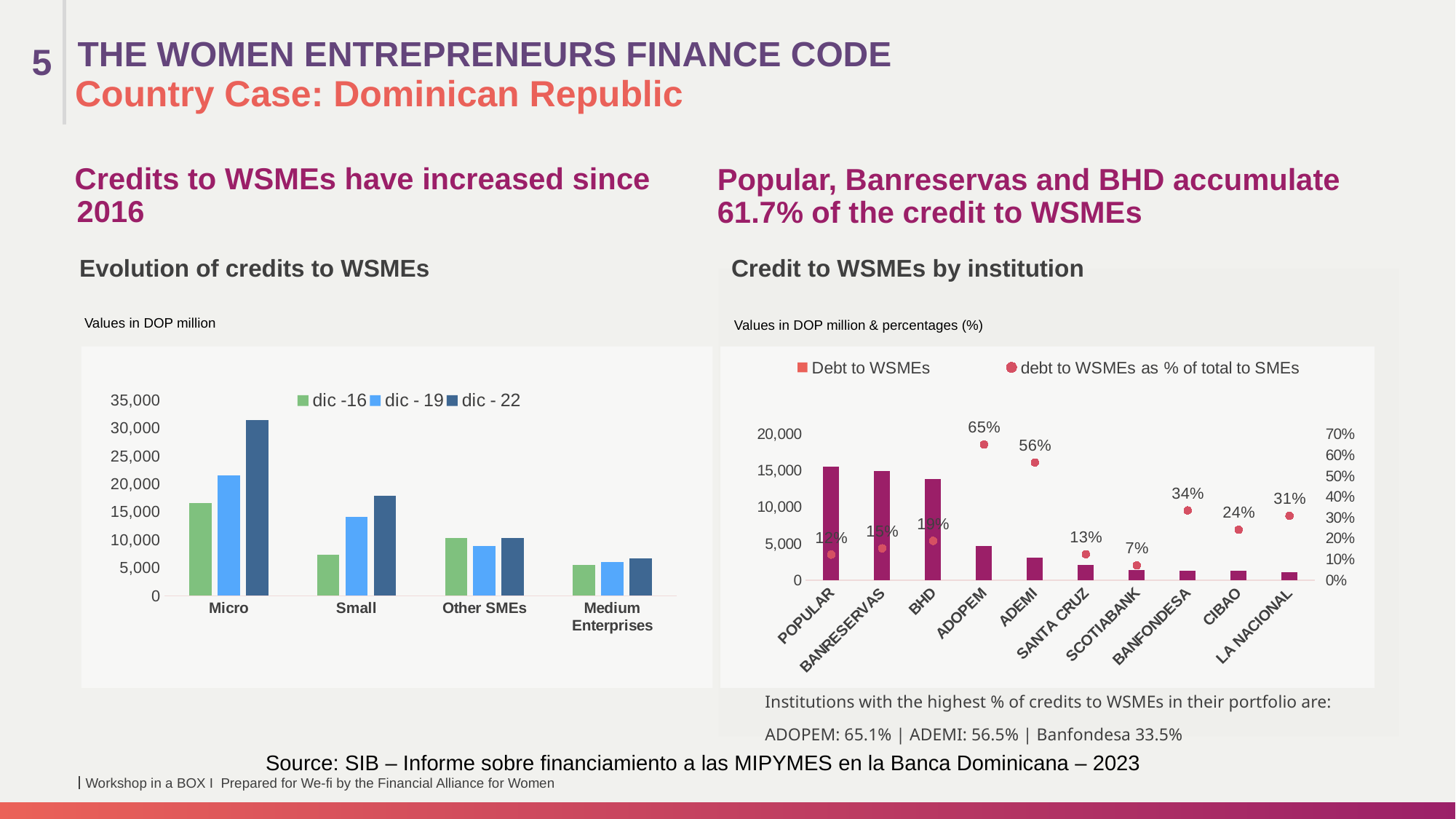
In the 'Evolution of credits to WSMEs' chart, do the values for Small rise or fall from dic -16 to dic - 22? rise How many series does the legend of the 'Evolution of credits to WSMEs' chart list? 3 In the 'Evolution of credits to WSMEs' chart, is the dic - 22 value for Micro greater or less than 30,000? greater How many categories are shown on the x axis of the 'Evolution of credits to WSMEs' chart? 4 What kind of chart is the 'Evolution of credits to WSMEs' chart? bar chart In the 'Evolution of credits to WSMEs' chart, for Other SMEs, which is larger: the dic -16 value or the dic - 19 value? dic -16 In the 'Credit to WSMEs by institution' chart, is the Debt to WSMEs bar for BHD greater or less than 10,000? greater In the 'Credit to WSMEs by institution' chart, which institution has the lowest debt to WSMEs as % of total to SMEs? SCOTIABANK In the 'Evolution of credits to WSMEs' chart, which category has the highest dic - 22 value? Micro In the 'Credit to WSMEs by institution' chart, what is the debt to WSMEs as % of total to SMEs for ADOPEM? 65% In the 'Credit to WSMEs by institution' chart, what is the difference between the percentages for BANFONDESA and CIBAO? 10% How many institutions are shown in the 'Credit to WSMEs by institution' chart? 10